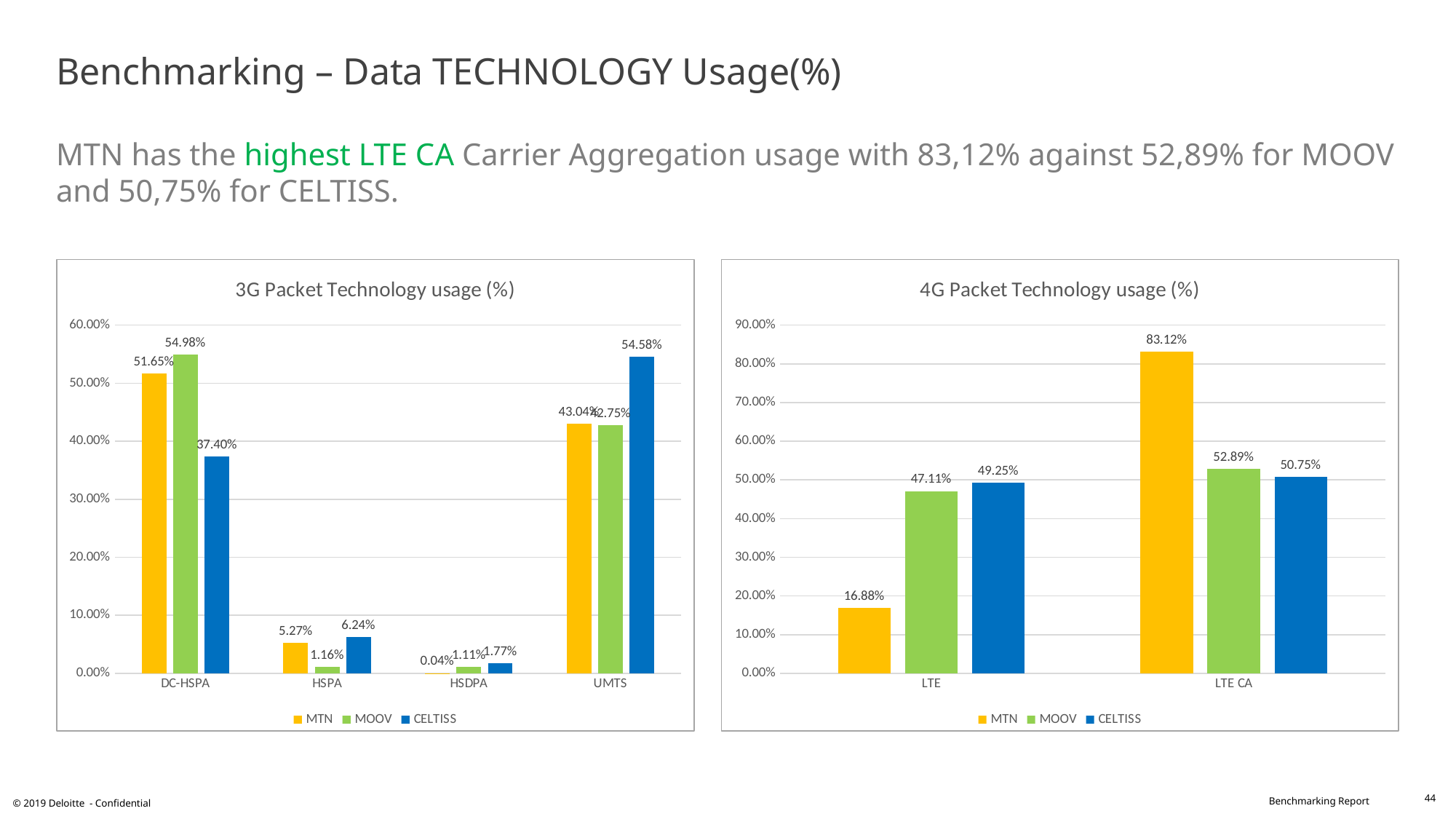
In the 4G Packet Technology usage (%) chart, which operator has the highest value in the LTE CA category? MTN What type of chart is the 4G Packet Technology usage (%) chart? Bar chart How many series does the legend of the 4G Packet Technology usage (%) chart list? 3 In the 4G Packet Technology usage (%) chart, what is the value for MTN in the LTE CA category? 83.12% How many categories are shown on the x axis of the 3G Packet Technology usage (%) chart? 4 In the 4G Packet Technology usage (%) chart, what is the value for CELTISS in the LTE category? 49.25% In the 3G Packet Technology usage (%) chart, what is the value for CELTISS in the HSPA category? 6.24% In the 4G Packet Technology usage (%) chart, what is the difference between MTN and MOOV in the LTE CA category? 30.23% In the 3G Packet Technology usage (%) chart, which operator has the highest value in the UMTS category? CELTISS In the 3G Packet Technology usage (%) chart, which is larger in the DC-HSPA category: MTN or CELTISS? MTN In the 3G Packet Technology usage (%) chart, what is the value for MOOV in the DC-HSPA category? 54.98% In the 4G Packet Technology usage (%) chart, which operator has the lowest value in the LTE category? MTN